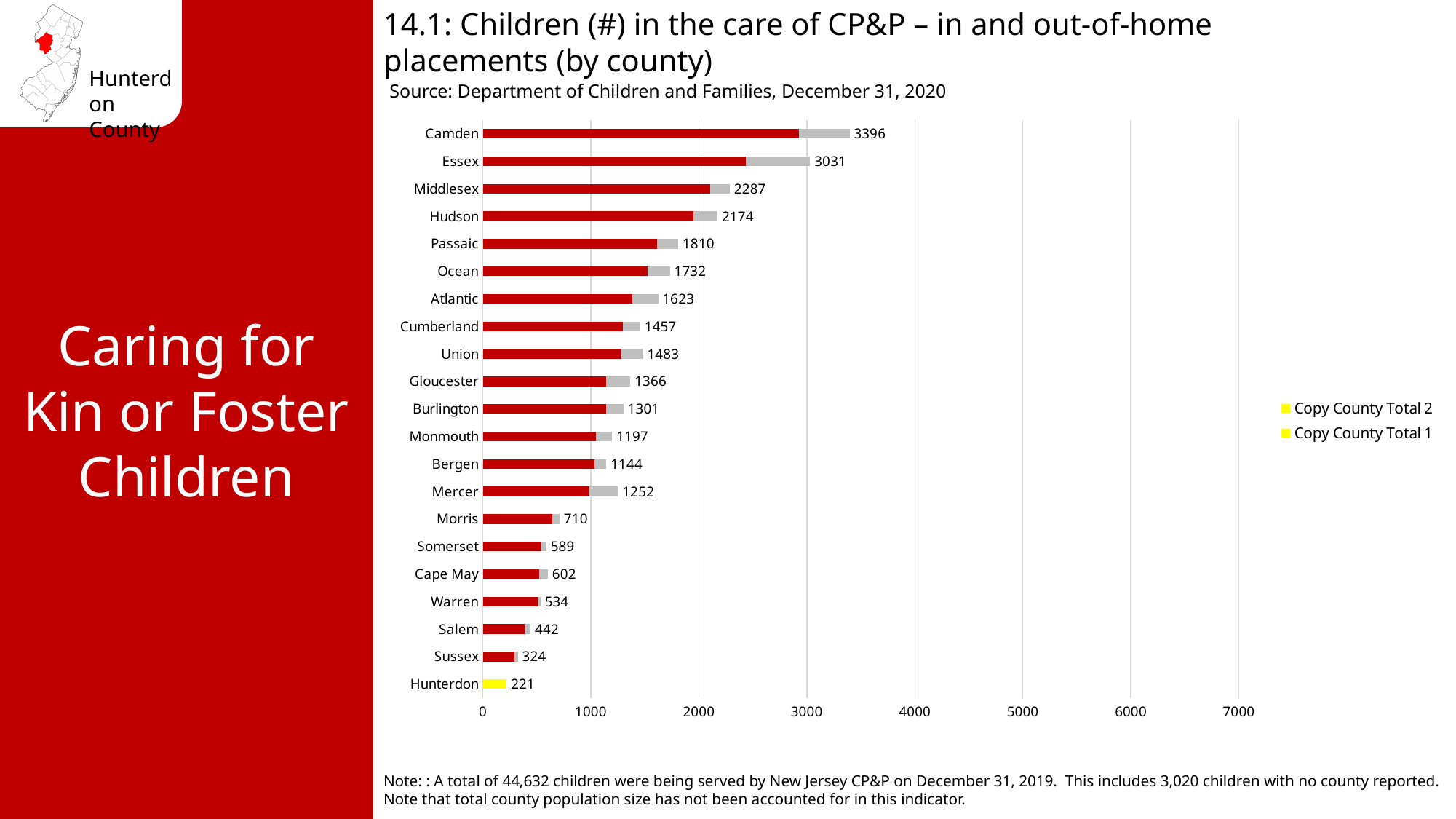
How many series does the legend list? 2 Which has a larger total, Mercer or Bergen? Mercer Which county has the lowest total? Hunterdon Is the red segment of the Camden bar greater or less than 2000? greater What is the difference between the totals for Camden and Essex? 365 How many counties are shown on the chart? 21 What is the value shown for Morris? 710 What is the value shown for Mercer? 1252 What is the value shown for Hunterdon? 221 Which county has the highest total? Camden What kind of chart is shown on the slide? Bar chart What is the total number of children in the care of CP&P for Camden? 3396